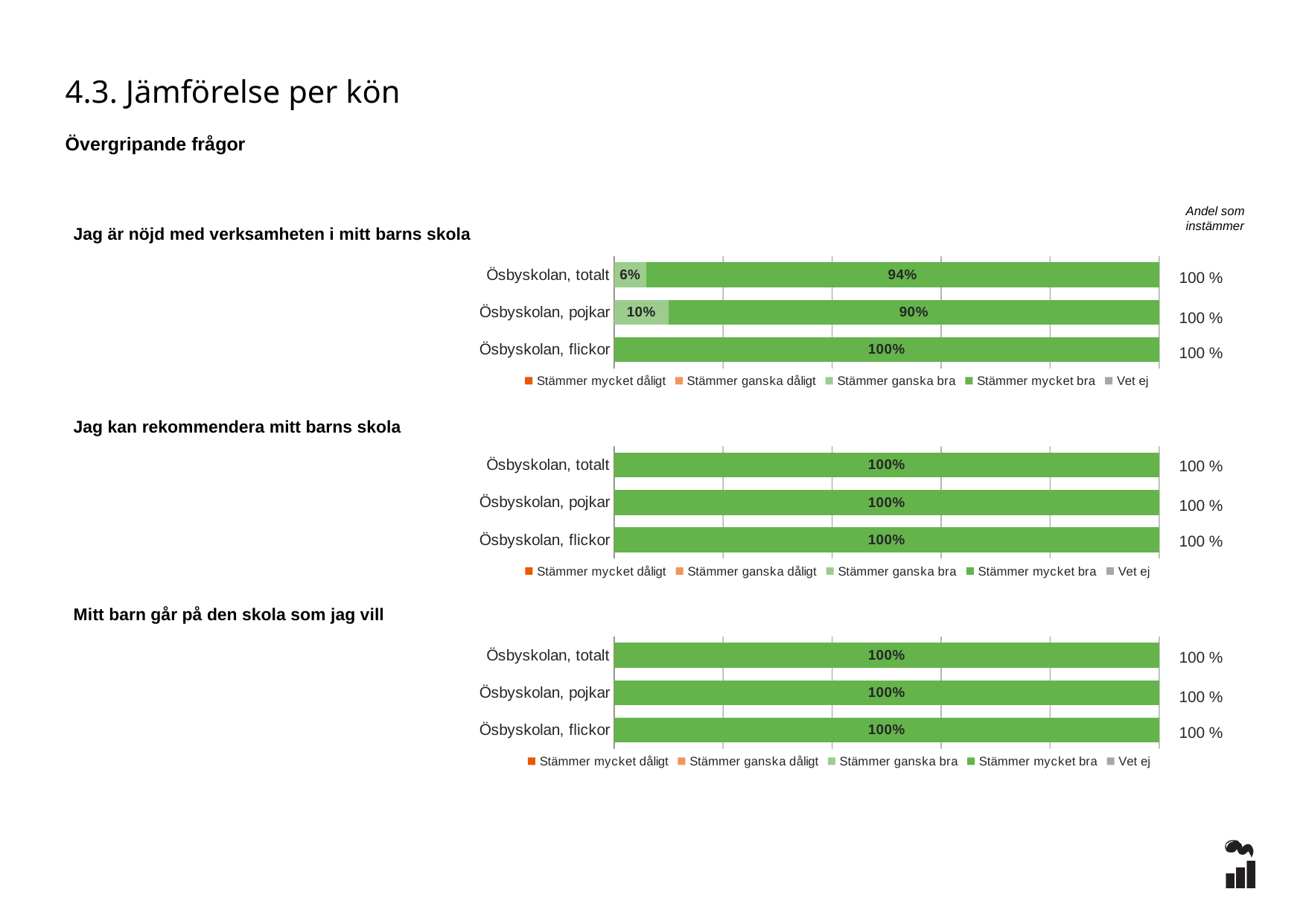
In the chart 'Jag är nöjd med verksamheten i mitt barns skola', what is the 'Stämmer ganska bra' value for Ösbyskolan, pojkar? 10% In the chart 'Jag är nöjd med verksamheten i mitt barns skola', which category has the lowest 'Stämmer mycket bra' value? Ösbyskolan, pojkar In the chart 'Jag är nöjd med verksamheten i mitt barns skola', which category has the highest 'Stämmer mycket bra' value? Ösbyskolan, flickor How many categories are shown in the chart 'Mitt barn går på den skola som jag vill'? 3 How many series does the legend of the chart 'Jag kan rekommendera mitt barns skola' list? 5 In the chart 'Mitt barn går på den skola som jag vill', what is the 'Stämmer mycket bra' value for Ösbyskolan, totalt? 100% In the chart 'Jag är nöjd med verksamheten i mitt barns skola', what is the difference between the 'Stämmer mycket bra' values for Ösbyskolan, totalt and Ösbyskolan, pojkar? 4% What kind of chart is 'Jag är nöjd med verksamheten i mitt barns skola'? Stacked bar chart In the chart 'Jag är nöjd med verksamheten i mitt barns skola', what is the 'Stämmer mycket bra' value for Ösbyskolan, flickor? 100% In the chart 'Jag är nöjd med verksamheten i mitt barns skola', what is the 'Stämmer mycket bra' value for Ösbyskolan, totalt? 94% In the chart 'Jag är nöjd med verksamheten i mitt barns skola', which is larger: the 'Stämmer ganska bra' value for Ösbyskolan, pojkar or for Ösbyskolan, totalt? Ösbyskolan, pojkar In the chart 'Jag kan rekommendera mitt barns skola', what is the 'Stämmer mycket bra' value for Ösbyskolan, pojkar? 100%